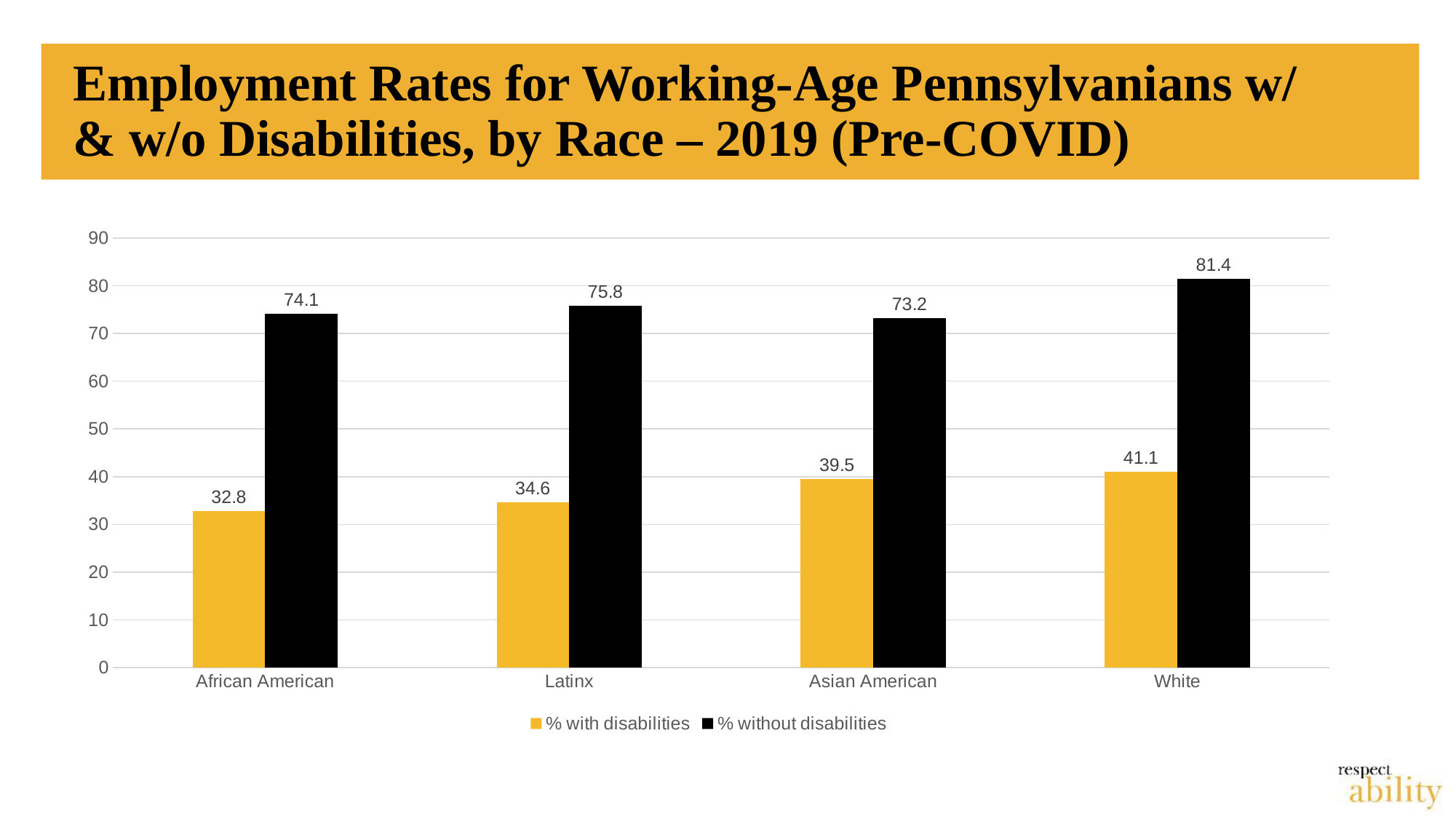
What is the difference between '% without disabilities' and '% with disabilities' for Latinx? 41.2 Which race category has the highest value for '% without disabilities'? White Which race category has the lowest value for '% with disabilities'? African American How many race categories are shown on the x axis? 4 Is the value for '% with disabilities' for White greater or less than 50? less What kind of chart is shown on the slide? bar chart What colour are the bars for '% without disabilities'? black What is the value for '% with disabilities' for African American? 32.8 How many series does the legend list? 2 What is the value for '% with disabilities' for Asian American? 39.5 Which is larger: '% without disabilities' for African American or for Asian American? African American What is the value for '% without disabilities' for White? 81.4